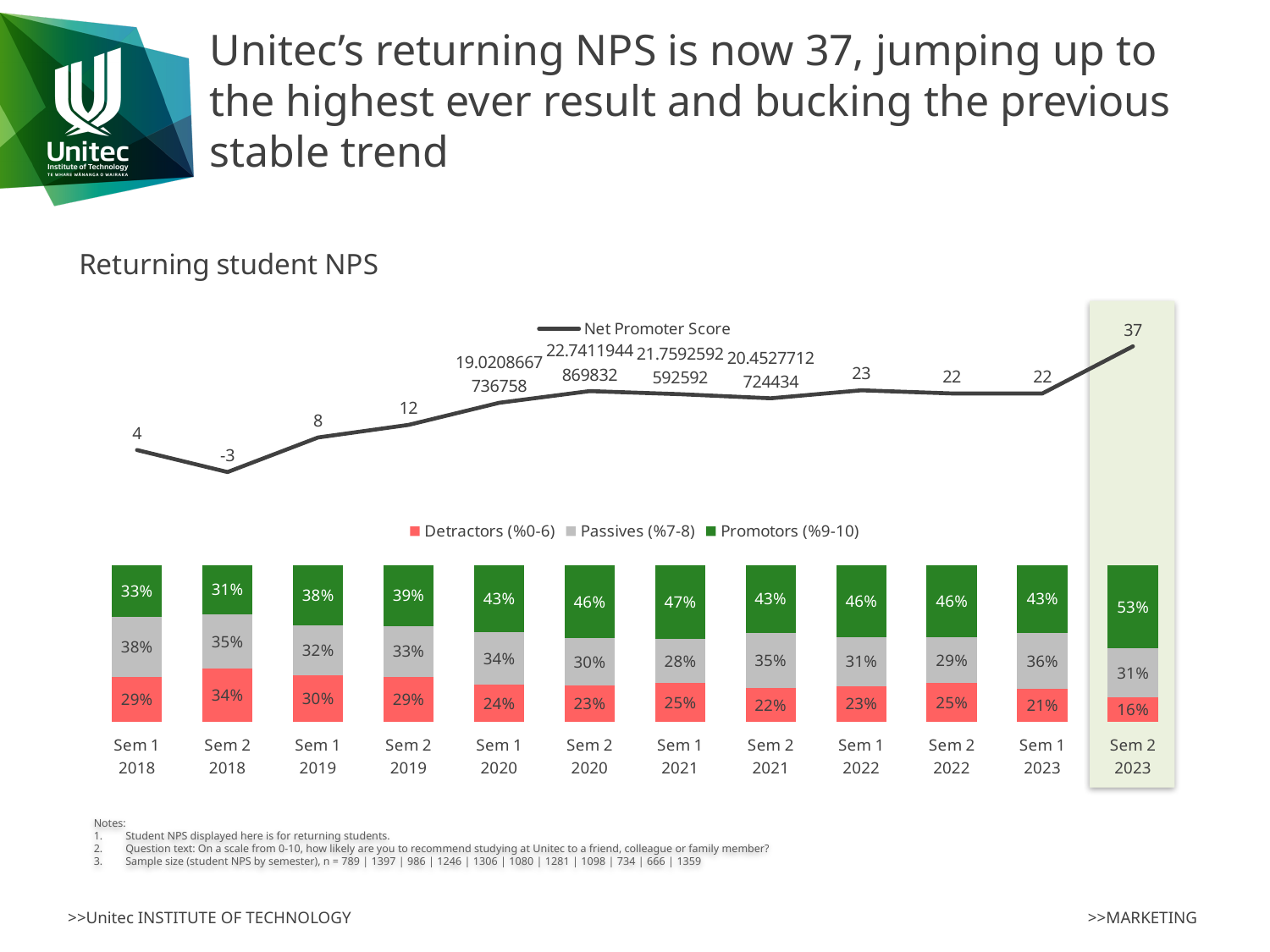
How many semesters are shown along the x axis of the stacked bar chart? 12 In the Net Promoter Score line chart, which semester has the lowest NPS? Sem 2 2018 In the stacked bar chart, what percentage of Sem 2 2023 returning students are Promoters (%9-10)? 53% In the stacked bar chart, which semester has the lowest Detractors (%0-6) percentage? Sem 2 2023 In the stacked bar chart, what percentage of Sem 2 2018 returning students are Detractors (%0-6)? 34% How many series does the legend of the stacked bar chart list? 3 In the Net Promoter Score line chart, what is the NPS for Sem 1 2018? 4 In the Net Promoter Score line chart, which semester has the highest NPS? Sem 2 2023 What kind of chart is the lower chart showing Detractors, Passives and Promoters? Stacked bar chart In the Net Promoter Score line chart, what is the difference between the NPS for Sem 2 2023 and Sem 1 2023? 15 In the Net Promoter Score line chart, what is the NPS for Sem 2 2023? 37 In the stacked bar chart, which is larger: the Passives (%7-8) percentage for Sem 1 2023 or for Sem 2 2023? Sem 1 2023